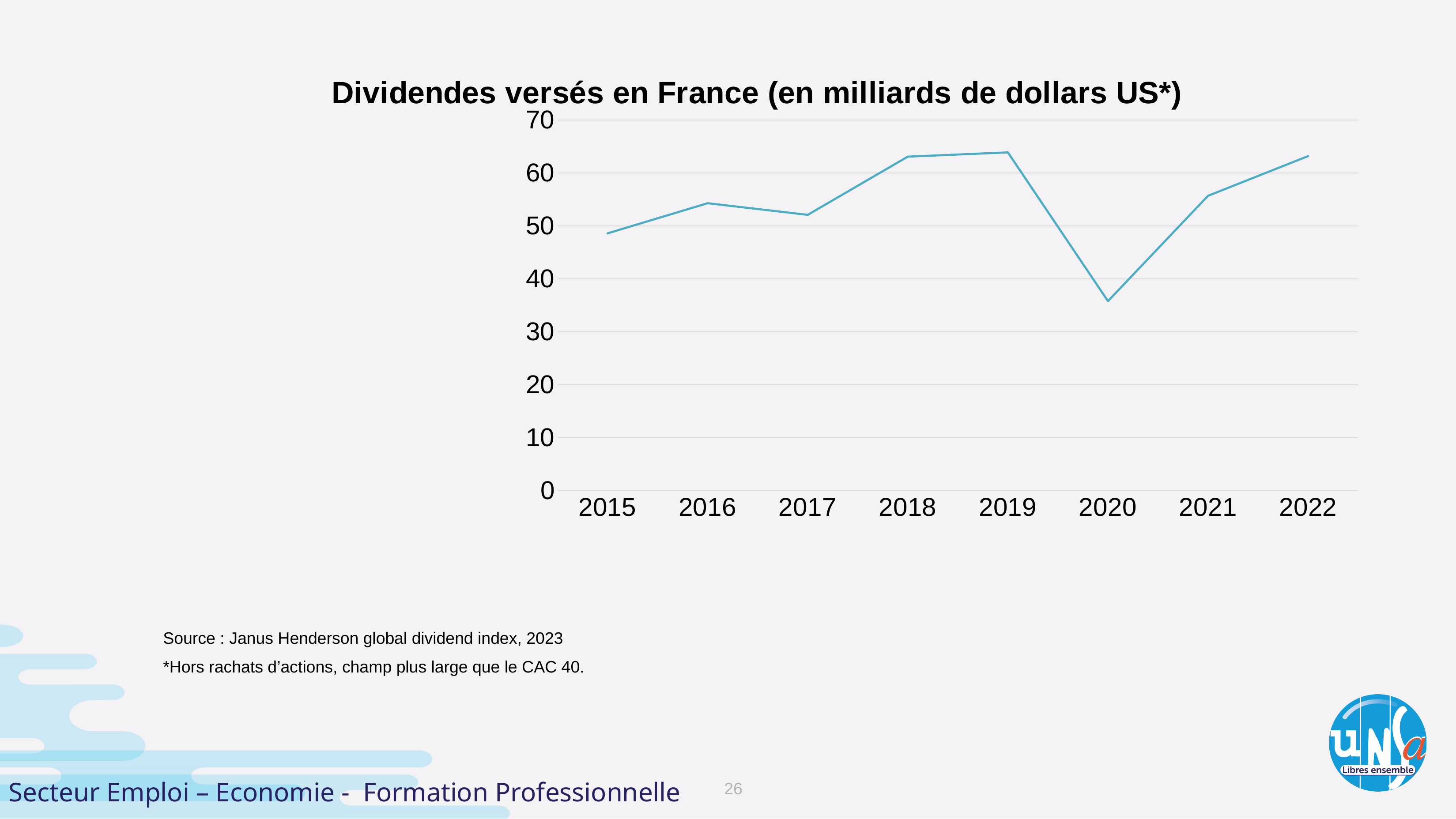
Is the value for 2015 greater or less than 50? less What kind of chart is shown on the slide? line chart Which year has the lowest value? 2020 Is the value for 2021 greater or less than 50? greater Which is larger, the value for 2018 or the value for 2017? 2018 Which is larger, the value for 2019 or the value for 2020? 2019 How many years are plotted on the x axis? 8 What is the title of the chart? Dividendes versés en France (en milliards de dollars US*) Is the value for 2020 greater or less than 40? less Does the value rise or fall from 2019 to 2020? fall